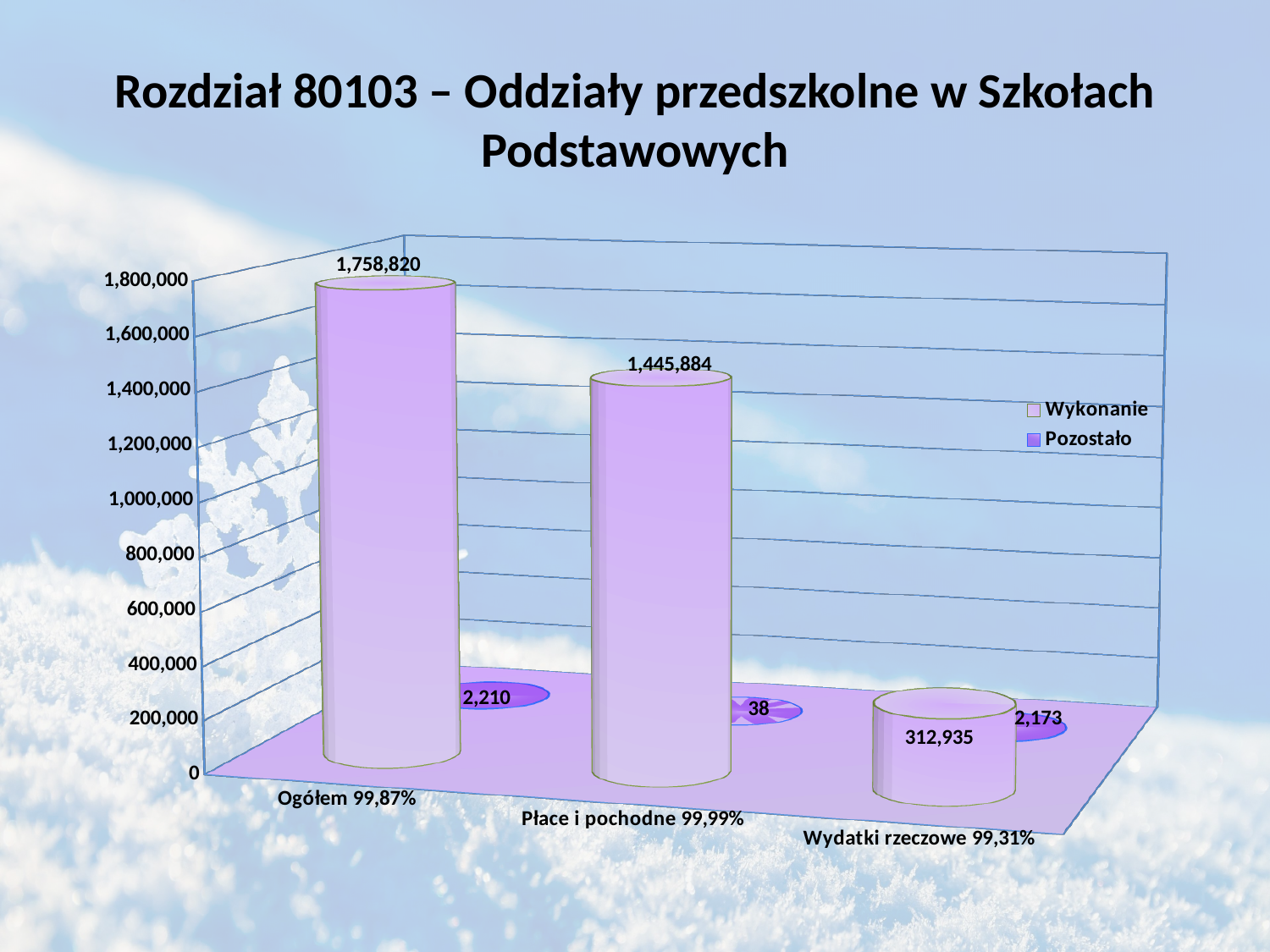
What is the Wykonanie value for Płace i pochodne 99,99%? 1,445,884 What is the Wykonanie value for Wydatki rzeczowe 99,31%? 312,935 What is the Wykonanie value for Ogółem 99,87%? 1,758,820 Is the Wykonanie value for Wydatki rzeczowe 99,31% greater or less than 400,000? less What is the Pozostało value for Wydatki rzeczowe 99,31%? 2,173 What is the difference between the Wykonanie values for Ogółem 99,87% and Płace i pochodne 99,99%? 312,936 What kind of chart is shown on the slide? bar chart How many series does the legend list? 2 What is the Pozostało value for Płace i pochodne 99,99%? 38 What is the Pozostało value for Ogółem 99,87%? 2,210 Which category has the highest Wykonanie value? Ogółem 99,87% Which category has the lowest Pozostało value? Płace i pochodne 99,99%